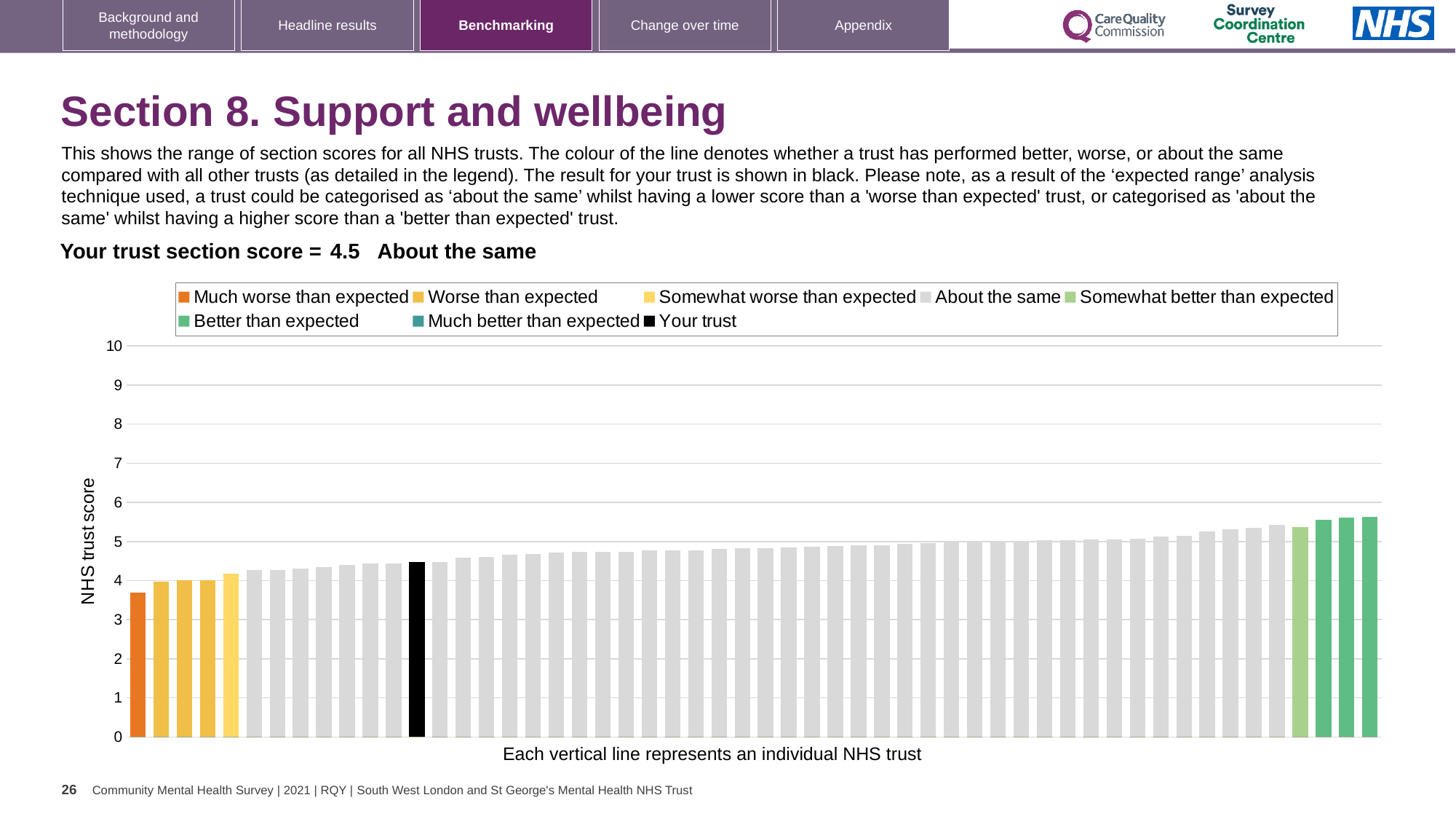
How many entries does the chart legend list? 8 Is the value of the highest bar (at the far right) greater or less than 6? less What is the section score for your trust shown on the slide? 4.5 Do the bar values rise or fall moving from left to right along the x axis? rise Is the value of the highest bar (at the far right) greater or less than 5? greater What kind of chart is shown on the slide? bar chart What is the label on the vertical axis of the chart? NHS trust score Is the value of the lowest bar (the orange bar at the far left) greater or less than 4? less Which is larger: the black 'Your trust' bar or the orange bar at the far left? the black 'Your trust' bar How many bars are coloured orange ('Much worse than expected')? 1